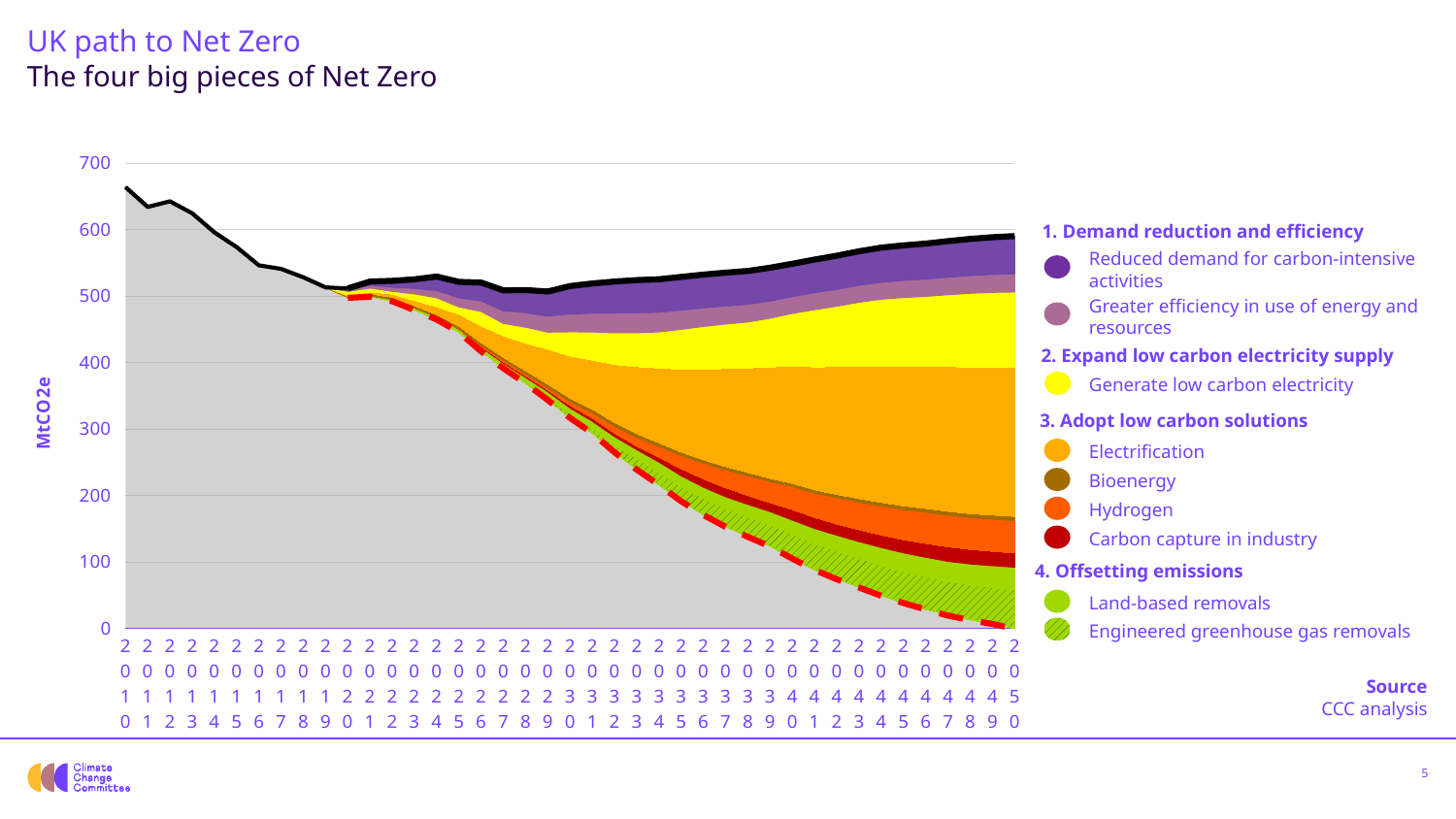
Is the value of the red dashed line in 2050 greater or less than 100? less What is the last year shown on the x axis? 2050 How many entries does the chart's legend list? 9 What is the first year shown on the x axis? 2010 Is the value of the red dashed line in 2040 greater or less than 200? less What is the highest value shown on the y axis of the chart? 700 What kind of chart is shown on the slide? Stacked area chart Is the value of the black line in 2010 greater or less than 600? greater What is the label on the y axis of the chart? MtCO2e Does the red dashed line rise or fall from 2020 to 2050? fall How many years are shown along the x axis of the chart? 41